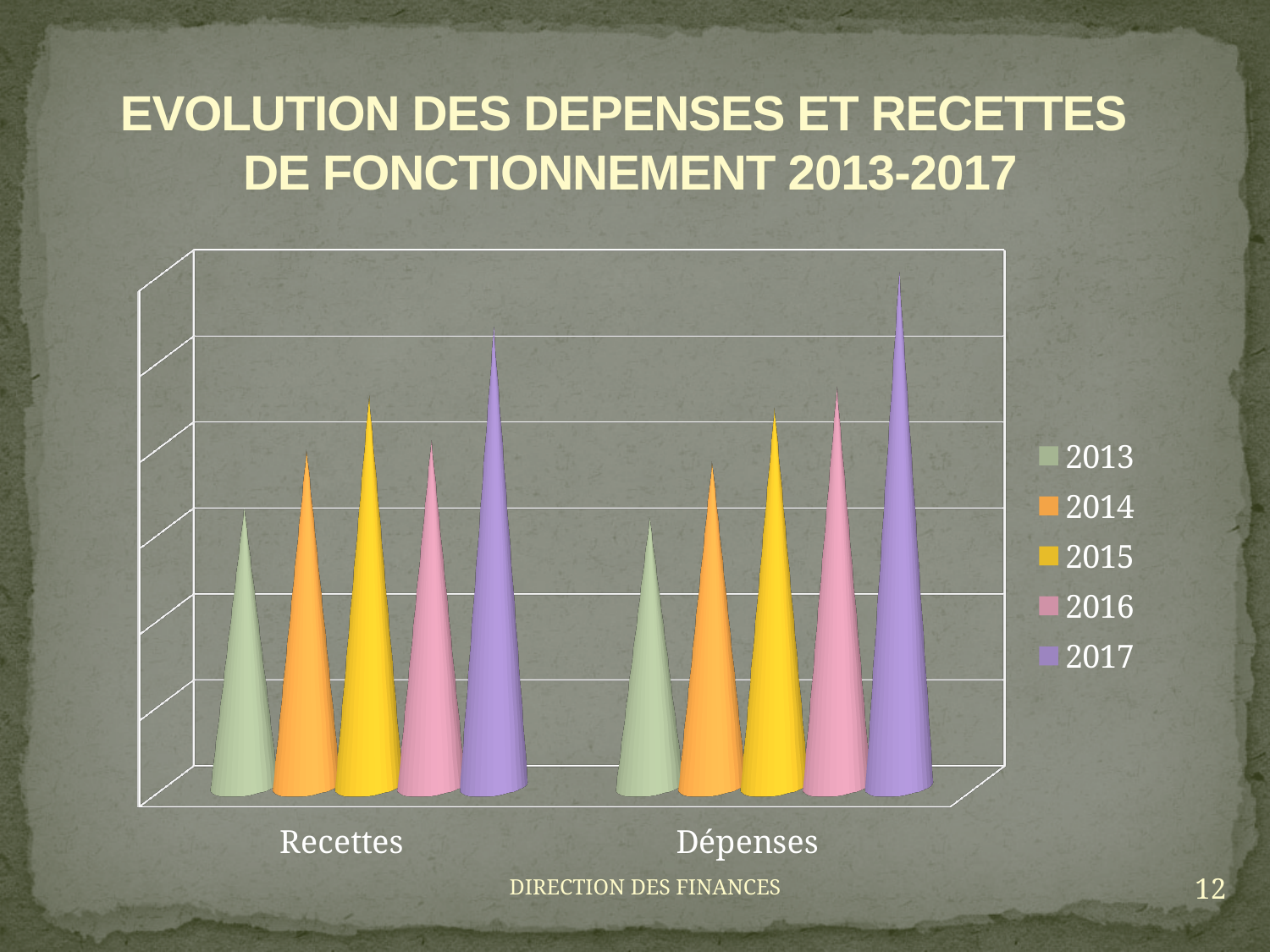
Which year has the lowest value for Dépenses? 2013 For Dépenses, which is larger: the value for 2015 or the value for 2016? 2016 For Recettes, which is larger: the value for 2015 or the value for 2016? 2015 Which year has the highest value for Dépenses? 2017 How many series does the chart legend list? 5 Do the Dépenses values rise or fall from 2013 to 2017? rise Which year has the lowest value for Recettes? 2013 What kind of chart is shown on the slide? bar chart Which year has the highest value for Recettes? 2017 What is the title of the chart on the slide? EVOLUTION DES DEPENSES ET RECETTES DE FONCTIONNEMENT 2013-2017 Which is larger: the 2017 value for Recettes or the 2017 value for Dépenses? Dépenses How many categories are shown on the x axis of the chart? 2